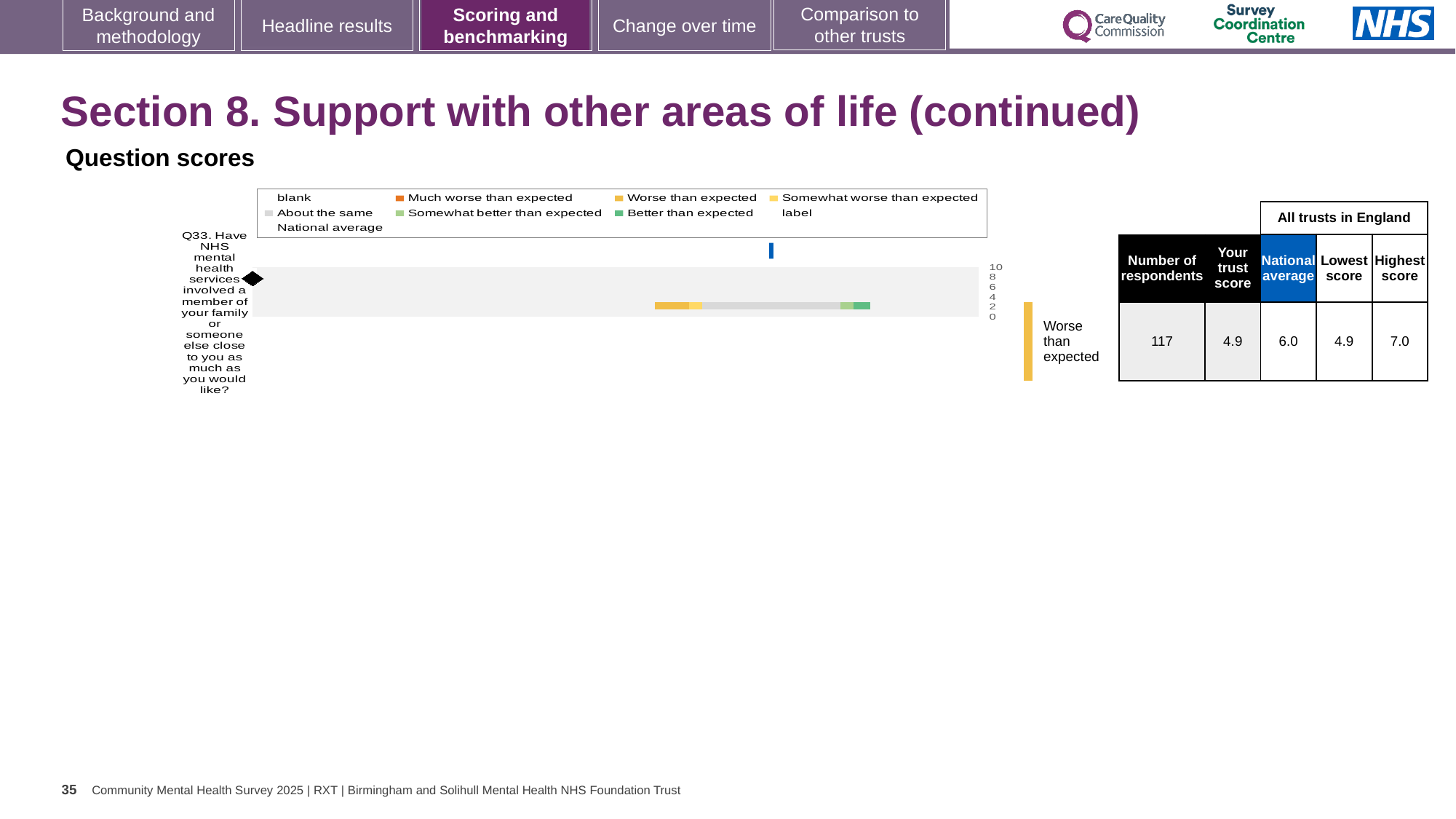
In the table beside the chart, what is the highest score among all trusts in England for Q33? 7.0 In the table beside the chart, what is the trust's score for Q33? 4.9 How many questions (categories) are plotted on the chart? 1 What is the difference between the national average and the trust's score for Q33? 1.1 Which is larger for Q33, the trust's score or the national average? national average In the table beside the chart, what is the national average for Q33? 6.0 What kind of chart is shown on the slide? bar chart What is the maximum value shown on the chart's score axis? 10 In the table beside the chart, what is the number of respondents for Q33? 117 According to the label next to the chart, how is the trust's score for Q33 categorised? Worse than expected Which question is plotted on the chart? Q33. Have NHS mental health services involved a member of your family or someone else close to you as much as you would like? In the table beside the chart, what is the lowest score among all trusts in England for Q33? 4.9